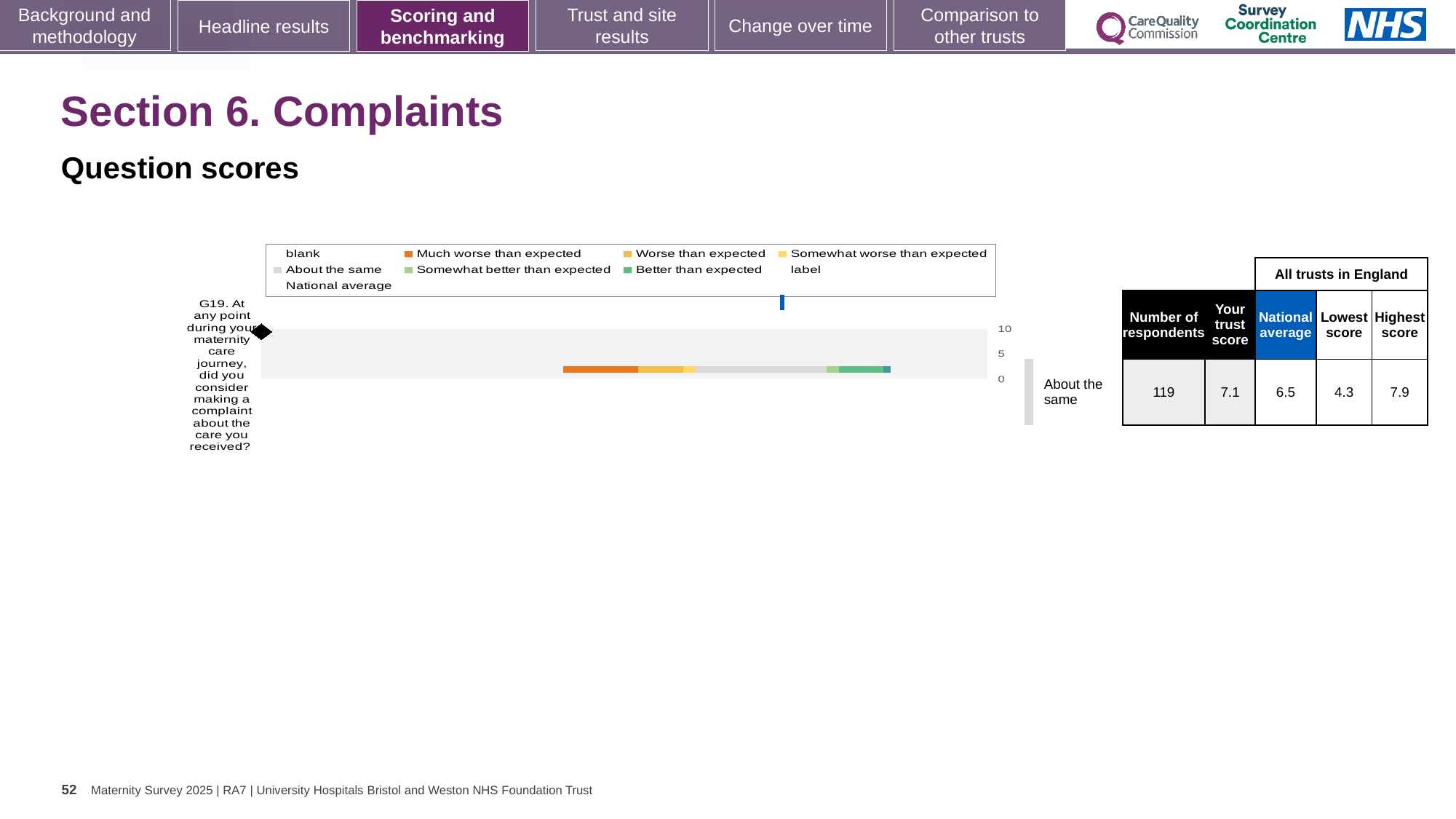
What is the national average score for question G19? 6.5 What is the difference between the highest score and the lowest score for question G19? 3.6 What kind of chart is shown on the slide? bar chart Which question number is plotted in the chart? G19 What is the trust score for question G19? 7.1 What is the lowest score among all trusts in England for question G19? 4.3 What benchmark category is question G19 rated as? About the same How many survey questions are plotted in the chart? 1 Is the trust score for question G19 greater or less than 5? greater What is the highest score among all trusts in England for question G19? 7.9 How many respondents answered question G19? 119 Which is larger for question G19, the trust score or the national average? trust score